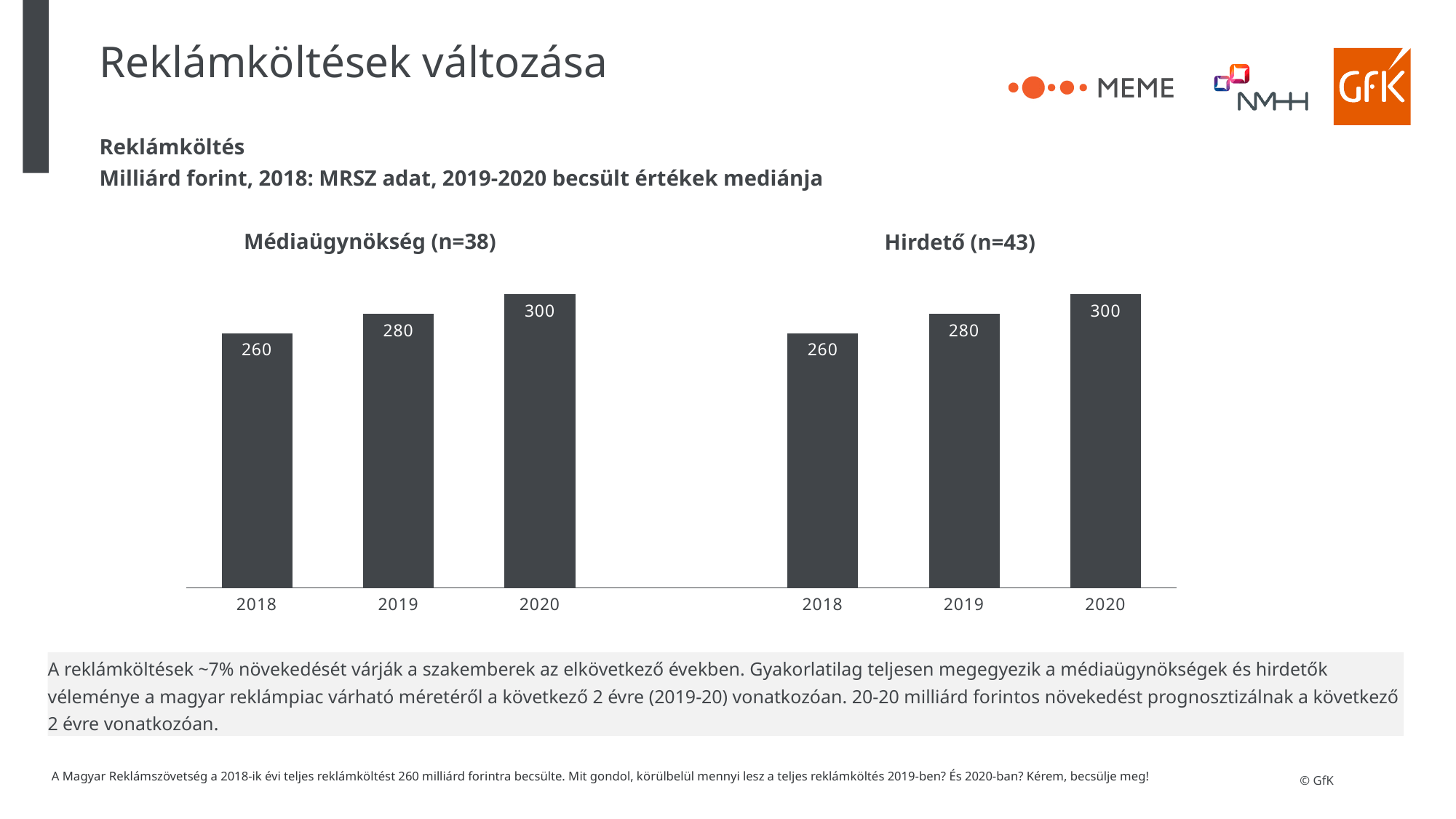
In the Médiaügynökség (n=38) chart, what is the value for 2019? 280 What is the title of the left chart? Médiaügynökség (n=38) In the Hirdető (n=43) chart, which is larger, the value for 2019 or the value for 2020? 2020 In the Médiaügynökség (n=38) chart, which year has the lowest value? 2018 In the Médiaügynökség (n=38) chart, what is the difference between the 2020 and 2018 values? 40 How many bars are in the Médiaügynökség (n=38) chart? 3 In the Hirdető (n=43) chart, what is the value for 2020? 300 In the Hirdető (n=43) chart, which year has the highest value? 2020 What kind of chart is the Hirdető (n=43) chart? Bar chart In the Médiaügynökség (n=38) chart, what is the value for 2018? 260 In the Médiaügynökség (n=38) chart, do the values rise or fall from 2018 to 2020? Rise In the Hirdető (n=43) chart, what is the difference between the 2019 and 2018 values? 20